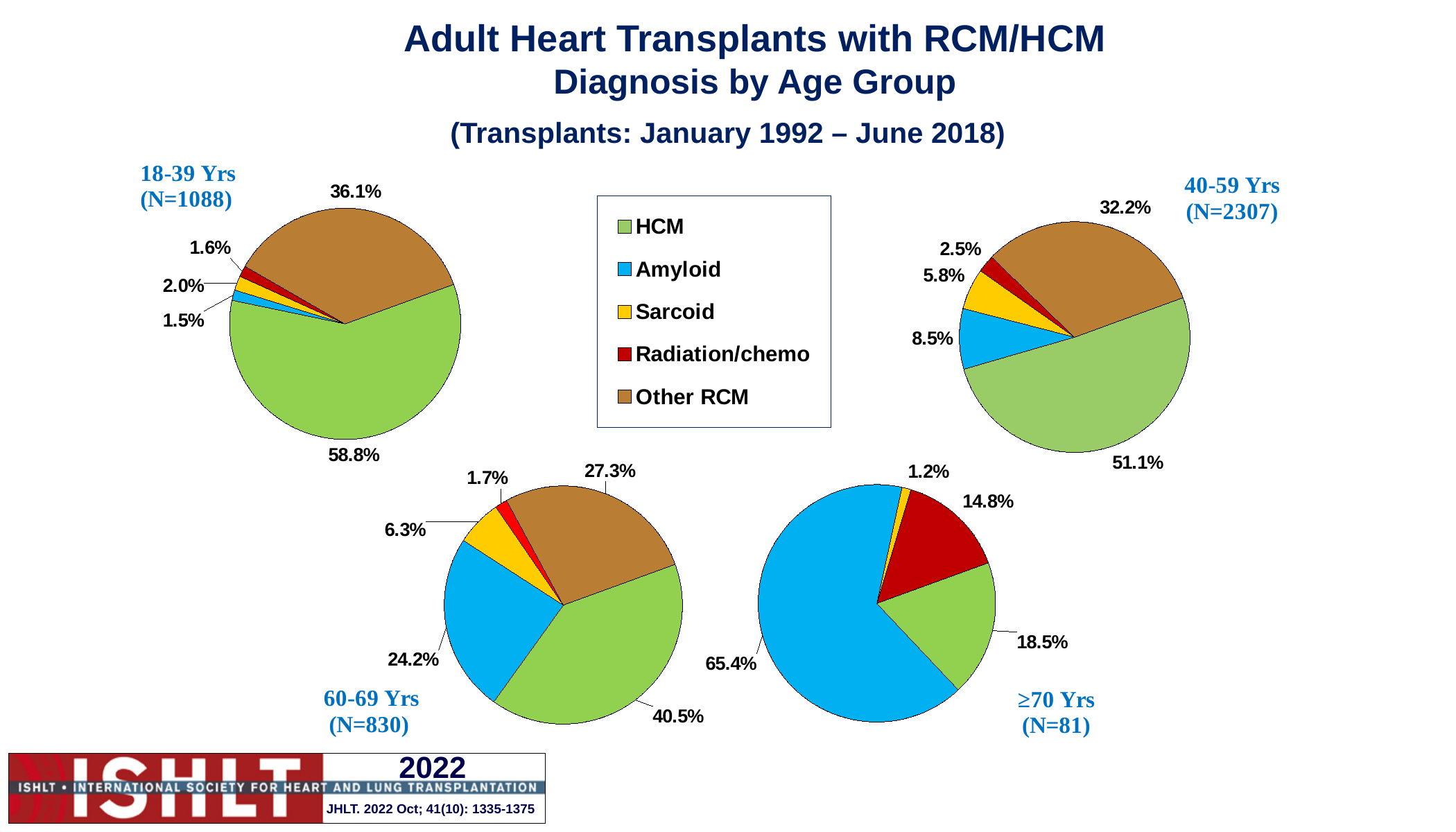
In the ≥70 Yrs pie chart, which diagnosis has the largest share? Amyloid In the 60-69 Yrs pie chart, what is the difference between the HCM share and the Amyloid share? 16.3% What is the N for the 40-59 Yrs age group? 2307 In the 18-39 Yrs pie chart, which diagnosis has the smallest share? Amyloid In the 40-59 Yrs pie chart, what share of transplants is Amyloid? 8.5% In the 60-69 Yrs pie chart, what share of transplants is Other RCM? 27.3% In the 18-39 Yrs pie chart, what share of transplants is HCM? 58.8% How many diagnosis categories does the legend list? 5 How many pie charts are shown on the slide? 4 In the ≥70 Yrs pie chart, what share of transplants is Radiation/chemo? 14.8% In the 40-59 Yrs pie chart, which is larger, the Sarcoid share or the Radiation/chemo share? Sarcoid What type of chart is used for the 60-69 Yrs age group? Pie chart